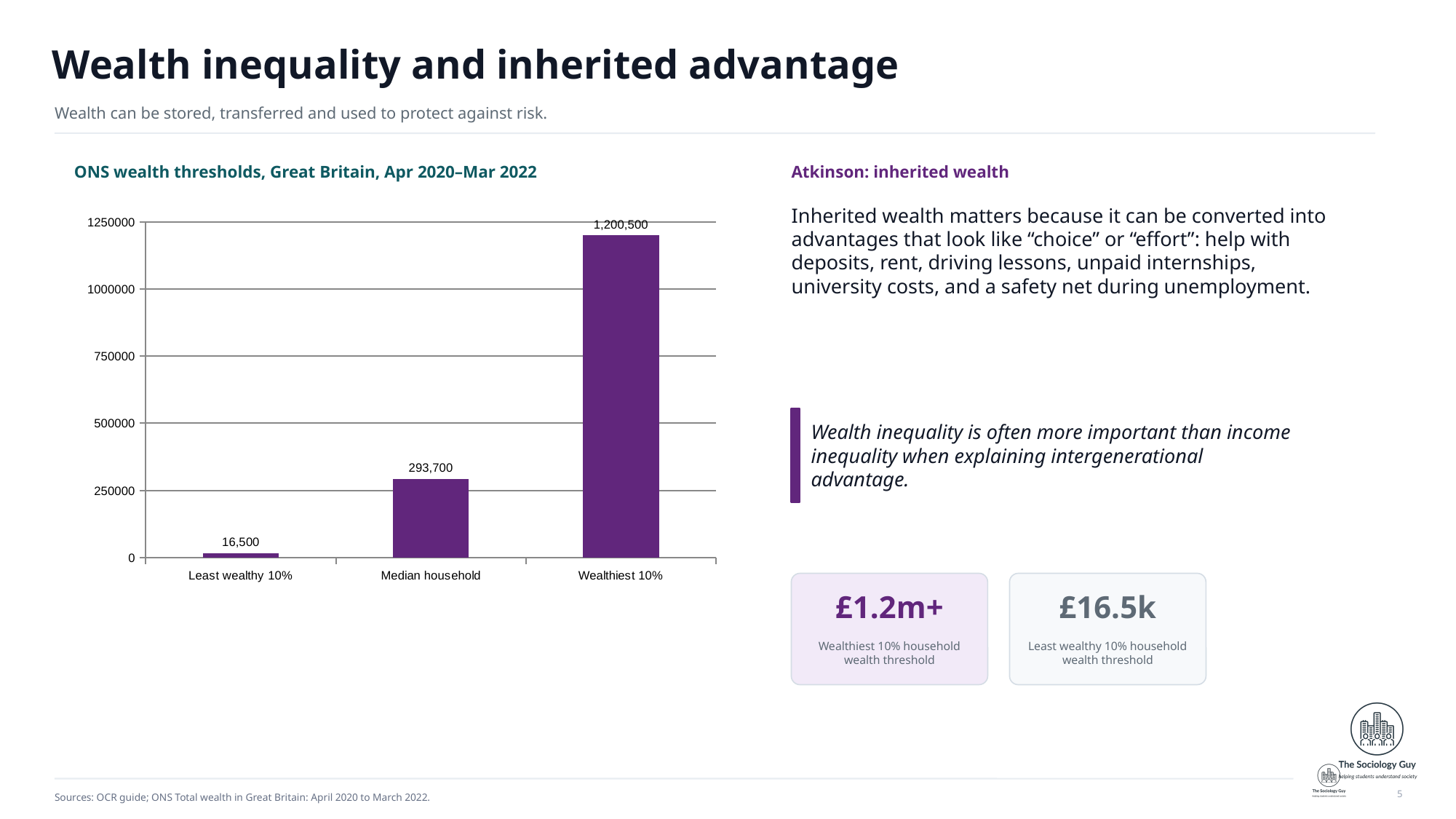
What kind of chart is shown on the slide? bar chart What is the value for Least wealthy 10%? 16,500 Which is larger, the value for Median household or the value for Least wealthy 10%? Median household Which category has the highest value? Wealthiest 10% What is the value for Median household? 293,700 Which category has the lowest value? Least wealthy 10% How many categories are shown on the x axis? 3 What is the difference between the values for Wealthiest 10% and Median household? 906,800 What is the difference between the values for Median household and Least wealthy 10%? 277,200 What is the title of the chart? ONS wealth thresholds, Great Britain, Apr 2020–Mar 2022 What is the value for Wealthiest 10%? 1,200,500 Is the value for Wealthiest 10% greater or less than 1000000? greater